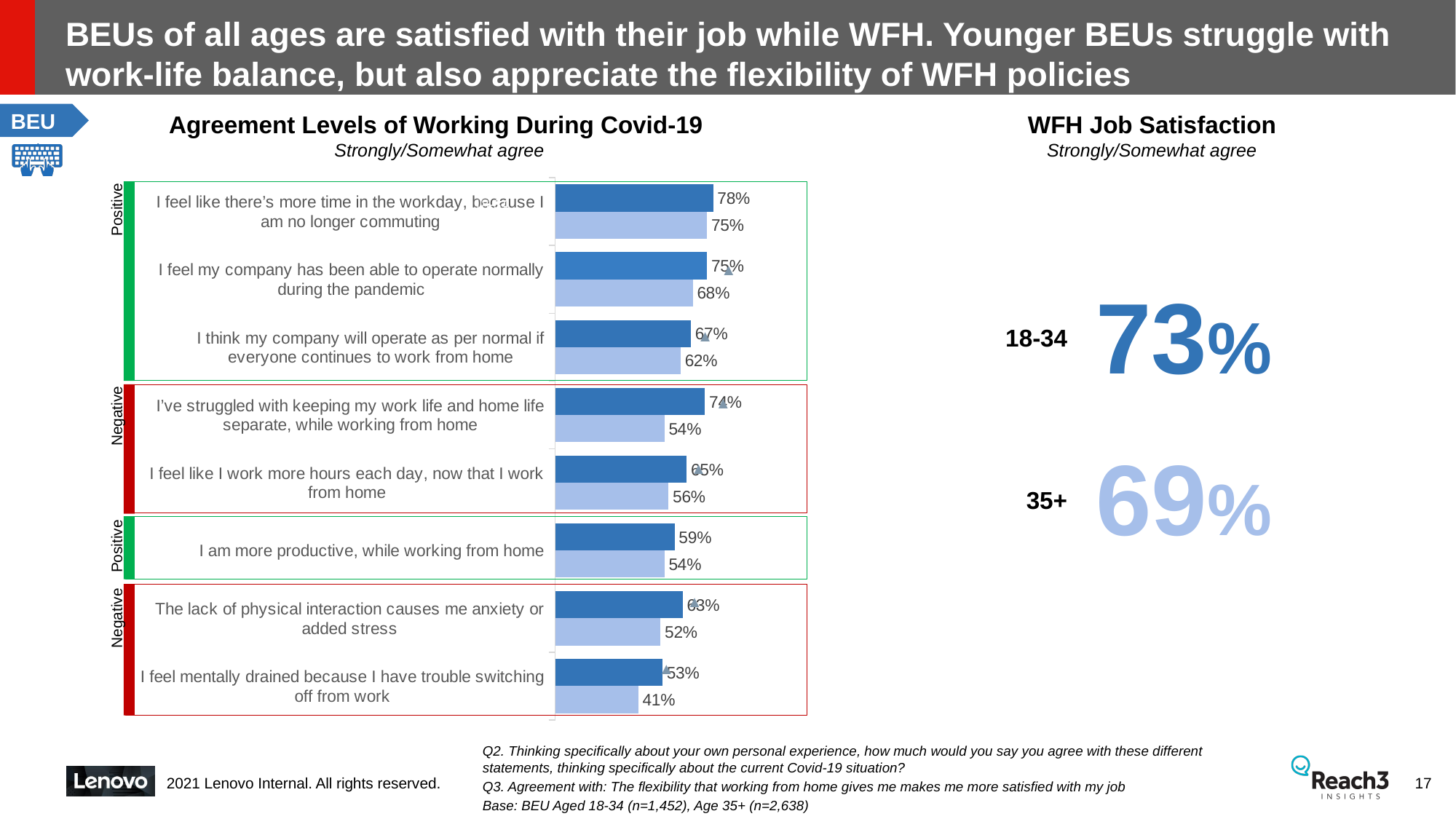
What kind of chart is 'Agreement Levels of Working During Covid-19'? bar chart In the 'Agreement Levels of Working During Covid-19' chart, what is the light blue bar value for 'I feel mentally drained because I have trouble switching off from work'? 41% In the 'Agreement Levels of Working During Covid-19' chart, what is the light blue bar value for 'I feel my company has been able to operate normally during the pandemic'? 68% In the 'Agreement Levels of Working During Covid-19' chart, what is the dark blue bar value for 'I feel like there's more time in the workday, because I am no longer commuting'? 78% In the 'Agreement Levels of Working During Covid-19' chart, which statement has the highest dark blue bar value? I feel like there's more time in the workday, because I am no longer commuting In the 'WFH Job Satisfaction' section, what is the value for the 18-34 age group? 73% In the 'Agreement Levels of Working During Covid-19' chart, what is the difference between the dark blue and light blue values for 'I feel mentally drained because I have trouble switching off from work'? 12 percentage points In the 'Agreement Levels of Working During Covid-19' chart, which is larger for 'I am more productive, while working from home': the dark blue bar or the light blue bar? the dark blue bar In the 'WFH Job Satisfaction' section, what is the difference between the 18-34 and 35+ values? 4 percentage points In the 'Agreement Levels of Working During Covid-19' chart, what is the light blue bar value for 'I've struggled with keeping my work life and home life separate, while working from home'? 54% In the 'Agreement Levels of Working During Covid-19' chart, which statement has the lowest light blue bar value? I feel mentally drained because I have trouble switching off from work How many statements are listed in the 'Agreement Levels of Working During Covid-19' chart? 8